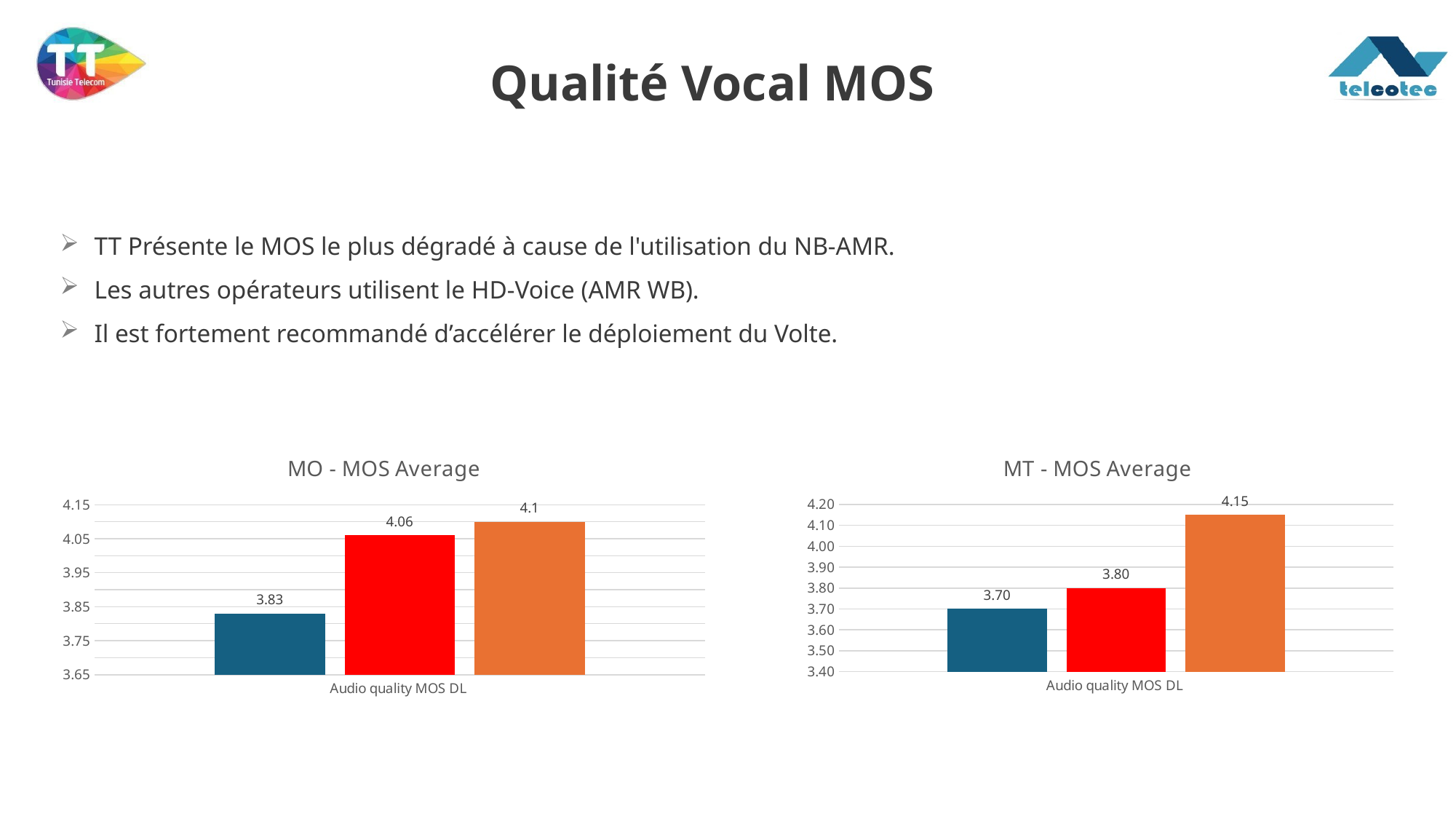
In the MT - MOS Average chart, what is the difference between the orange bar and the blue bar? 0.45 In the MO - MOS Average chart, what is the value of the red bar? 4.06 In the MT - MOS Average chart, what is the value of the orange bar? 4.15 How many bars are plotted in the MO - MOS Average chart? 3 In the MO - MOS Average chart, what is the value of the orange bar? 4.1 In the MT - MOS Average chart, what is the value of the blue bar? 3.70 In the MO - MOS Average chart, what is the value of the blue bar? 3.83 What type of chart is the MT - MOS Average chart? Bar chart In the MT - MOS Average chart, is the red bar or the blue bar larger? Red bar In the MO - MOS Average chart, which bar colour has the lowest value? Blue In the MO - MOS Average chart, what is the difference between the red bar and the blue bar? 0.23 In the MT - MOS Average chart, which bar colour has the highest value? Orange